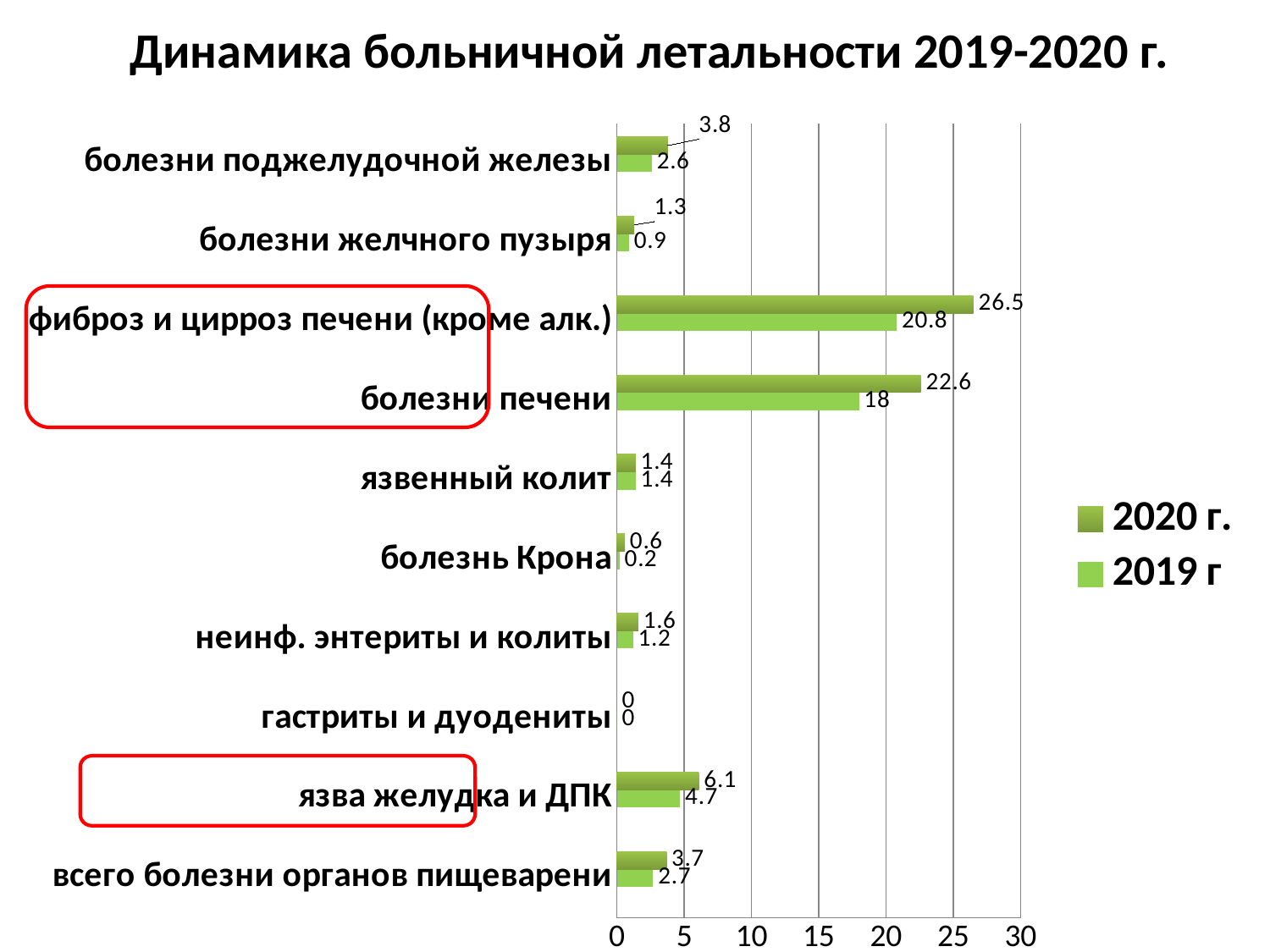
What is the difference between the 2020 г. and 2019 г values for болезни печени? 4.6 How many series does the legend list? 2 What kind of chart is shown on the slide? bar chart How many categories are shown on the chart? 10 Is the 2019 г value for фиброз и цирроз печени (кроме алк.) greater or less than 20? greater What is the 2019 г value for болезни печени? 18 Which category has the highest 2020 г. value? фиброз и цирроз печени (кроме алк.) What is the 2019 г value for язва желудка и ДПК? 4.7 Which is larger for болезни поджелудочной железы: the 2020 г. value or the 2019 г value? 2020 г. What is the title of the chart? Динамика больничной летальности 2019-2020 г. What is the 2020 г. value for фиброз и цирроз печени (кроме алк.)? 26.5 Which category has the lowest 2019 г value? гастриты и дуодениты